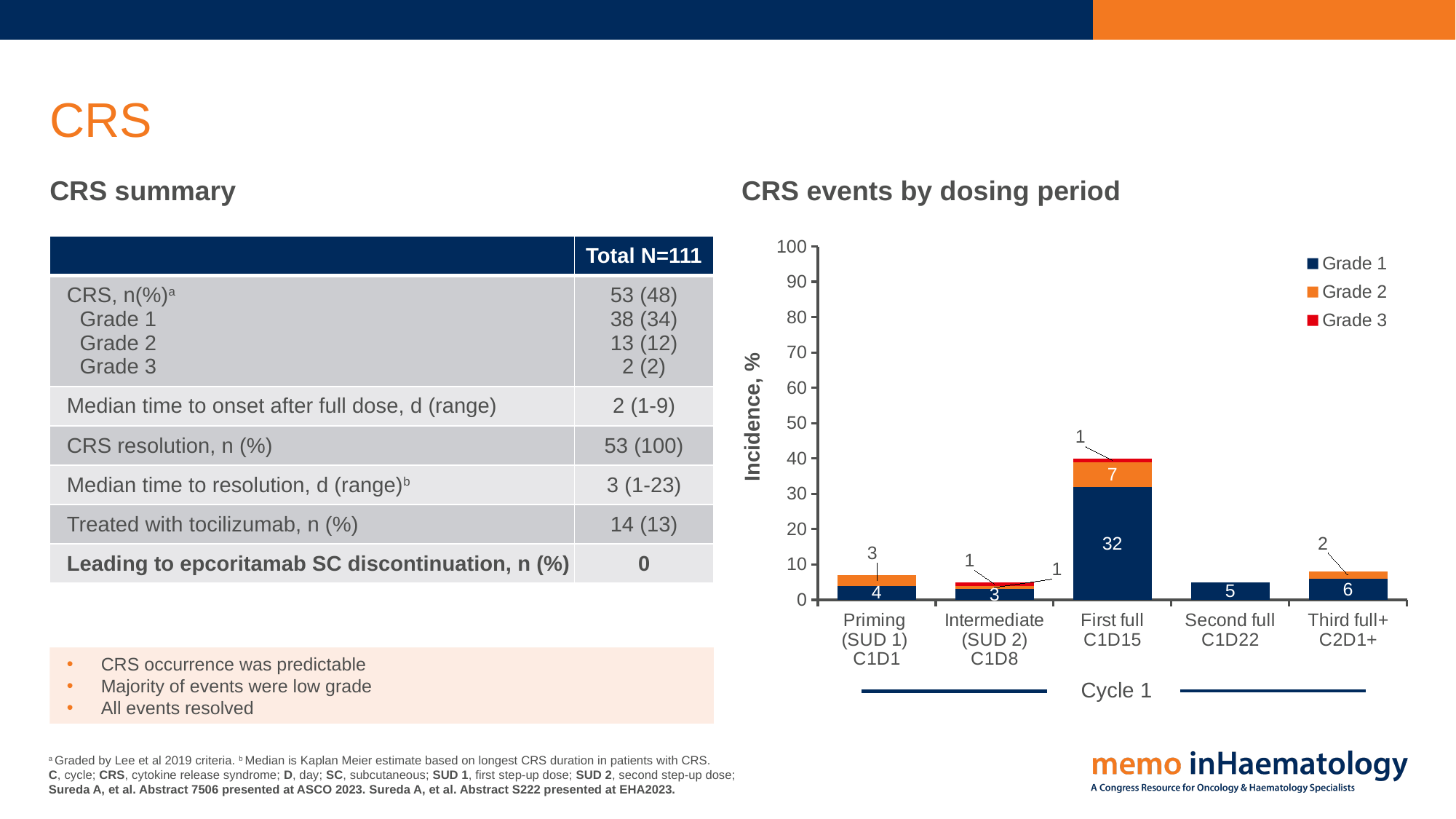
In the 'CRS events by dosing period' chart, what is the Grade 1 value for First full C1D15? 32 In the 'CRS events by dosing period' chart, what is the Grade 2 value for Third full+ C2D1+? 2 How many series does the legend of the 'CRS events by dosing period' chart list? 3 How many dosing periods are shown on the x axis of the 'CRS events by dosing period' chart? 5 In the 'CRS events by dosing period' chart, what is the Grade 2 value for Priming (SUD 1) C1D1? 3 In the 'CRS events by dosing period' chart, what is the total stacked value for First full C1D15? 40 In the 'CRS events by dosing period' chart, what is the difference between the Grade 1 values for First full C1D15 and Third full+ C2D1+? 26 In the 'CRS events by dosing period' chart, is the Grade 1 value larger for Second full C1D22 or Third full+ C2D1+? Third full+ C2D1+ What type of chart is 'CRS events by dosing period'? stacked bar chart In the 'CRS events by dosing period' chart, what is the total stacked value for Priming (SUD 1) C1D1? 7 In the 'CRS events by dosing period' chart, what is the Grade 1 value for Second full C1D22? 5 In the 'CRS events by dosing period' chart, which dosing period has the highest Grade 1 incidence? First full C1D15